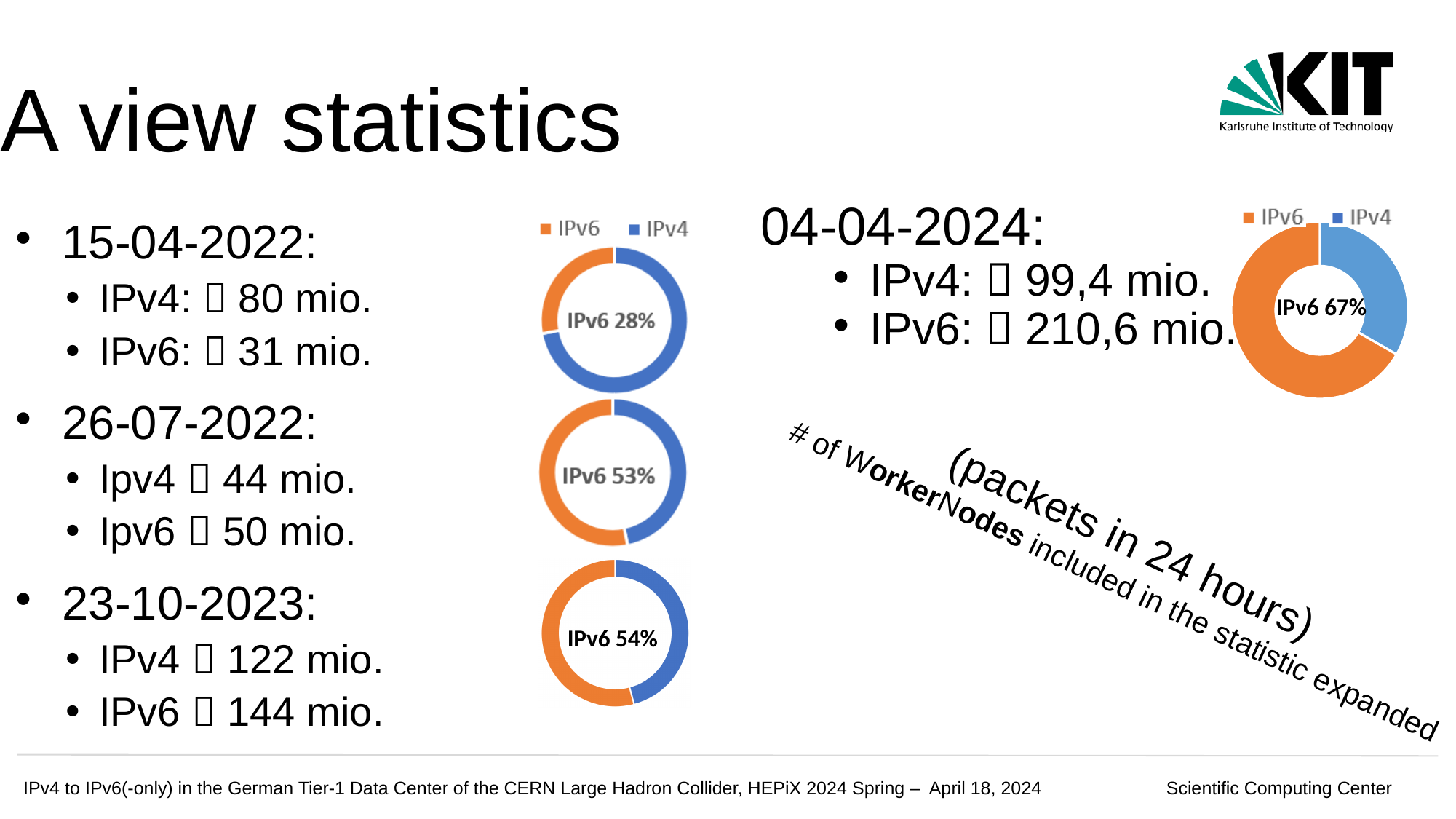
In the bottom donut chart of the three stacked in the centre of the slide, which slice is larger, IPv4 or IPv6? IPv6 Which colour represents IPv4 in the donut charts? Blue How many series does the legend above the stacked donut charts list? 2 In the bottom donut chart of the three stacked in the centre of the slide, what share is labelled for IPv6? 54% In the donut chart on the right side of the slide, which slice is larger, IPv4 or IPv6? IPv6 In the topmost donut chart in the middle of the slide, which slice is larger, IPv4 or IPv6? IPv4 In the donut chart on the right side of the slide, what share is labelled for IPv6? 67% Which colour represents IPv6 in the donut charts? Orange In the middle donut chart of the three stacked in the centre of the slide, what share is labelled for IPv6? 53% What kind of chart is used on this slide to show the IPv4/IPv6 split? Pie (donut) chart In the topmost donut chart in the middle of the slide, what share is labelled for IPv6? 28% How many donut charts are shown on the slide in total? 4